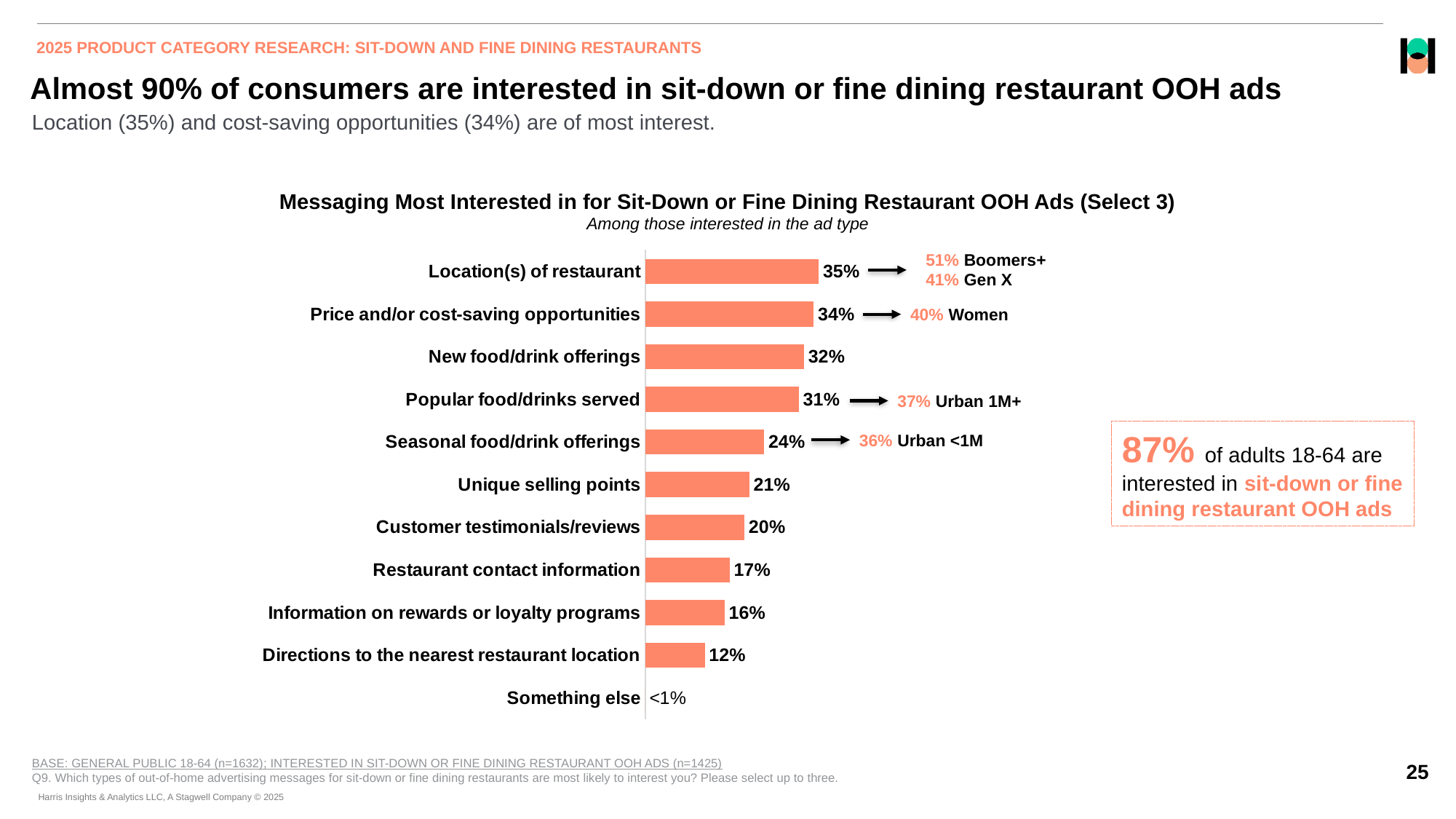
Which messaging category has the highest value in the chart? Location(s) of restaurant What is the difference between the values for 'Price and/or cost-saving opportunities' and 'Restaurant contact information'? 17% What is the title of the chart? Messaging Most Interested in for Sit-Down or Fine Dining Restaurant OOH Ads (Select 3) How many messaging categories are shown in the chart? 11 Which messaging category has the lowest value in the chart? Something else Which has a higher value: 'Unique selling points' or 'Customer testimonials/reviews'? Unique selling points What type of chart is used to show the messaging interest data? Bar chart Do the bar values increase or decrease from the top of the chart to the bottom? Decrease What percentage of respondents selected 'Location(s) of restaurant' as messaging they are most interested in? 35% According to the callout next to 'Popular food/drinks served', what percentage of Urban 1M+ respondents selected it? 37% What is the value shown for 'Seasonal food/drink offerings'? 24% What is the value shown for 'Directions to the nearest restaurant location'? 12%